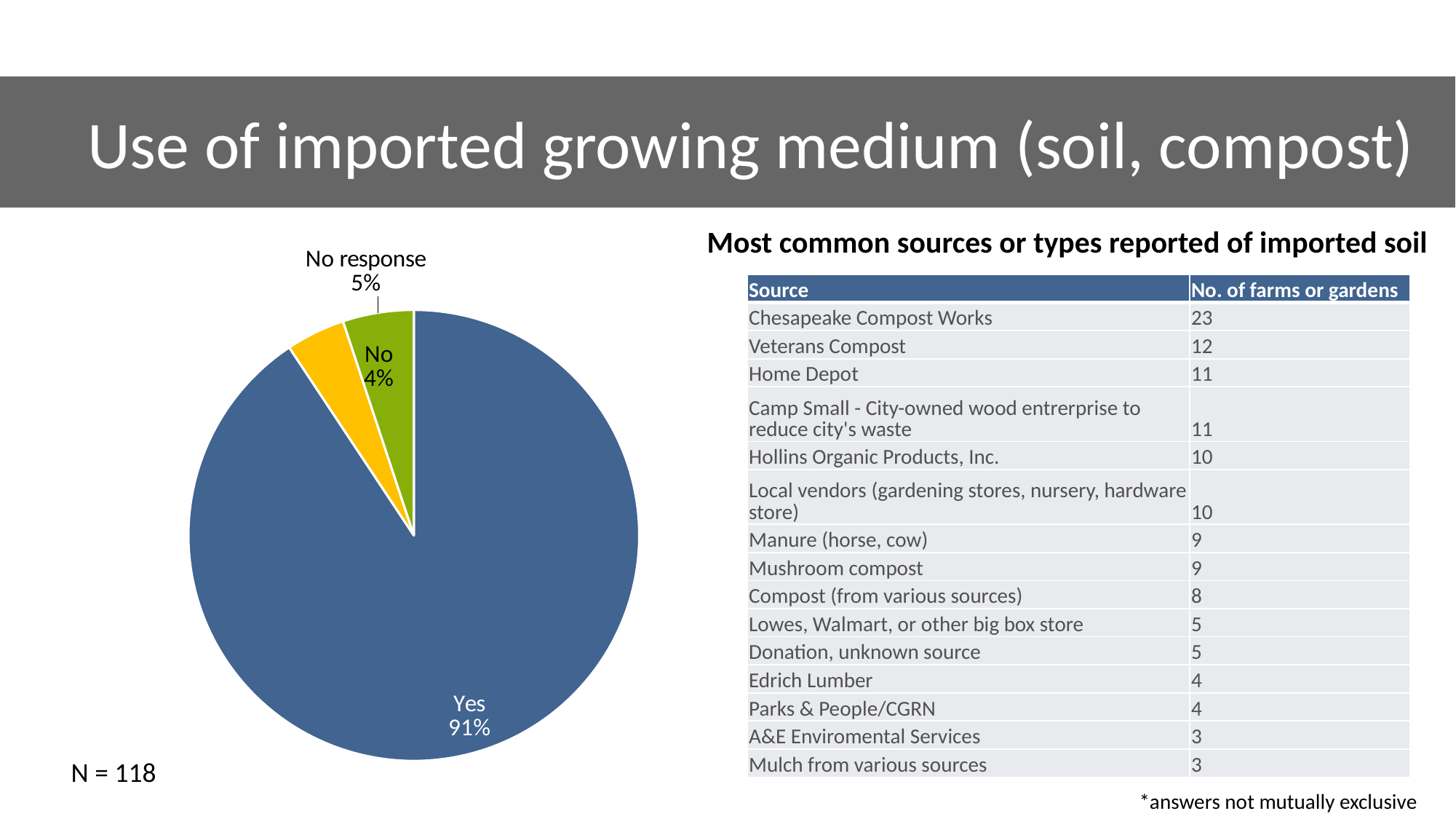
What sample size (N) is stated below the pie chart? N = 118 In the pie chart, what share is labelled No response? 5% How many slices does the pie chart have? 3 In the pie chart, what share of respondents answered Yes? 91% In the pie chart, which is larger, the No slice or the No response slice? No response Which slice of the pie chart is the largest? Yes What is the difference in percentage points between the Yes slice and the No response slice in the pie chart? 86 What is the combined share of the No and No response slices in the pie chart? 9% What kind of chart is shown on the left of the slide? pie chart In the pie chart, what share of respondents answered No? 4% Which slice of the pie chart is the smallest? No What colour is the Yes slice in the pie chart? blue